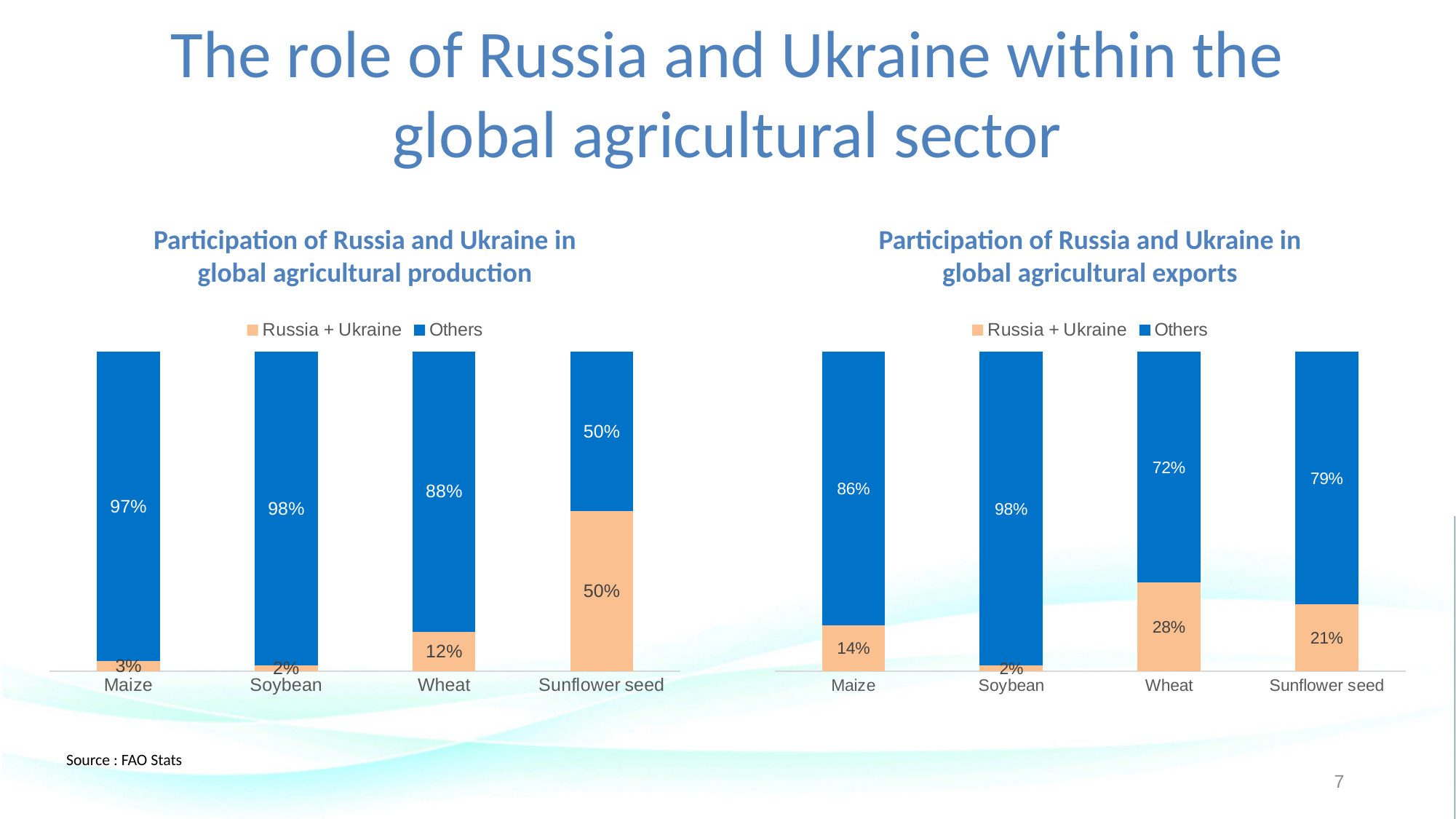
How many series does the legend of the 'Participation of Russia and Ukraine in global agricultural production' chart list? 2 What are the two series listed in the legend of the 'Participation of Russia and Ukraine in global agricultural exports' chart? Russia + Ukraine and Others In the 'Participation of Russia and Ukraine in global agricultural production' chart, is the Russia + Ukraine value for Sunflower seed larger or smaller than the Russia + Ukraine value for Wheat? larger How many categories are shown on the x axis of the 'Participation of Russia and Ukraine in global agricultural exports' chart? 4 In the 'Participation of Russia and Ukraine in global agricultural exports' chart, what is the Others value for Sunflower seed? 79% In the 'Participation of Russia and Ukraine in global agricultural production' chart, which category has the highest Russia + Ukraine share? Sunflower seed In the 'Participation of Russia and Ukraine in global agricultural production' chart, what is the total of the Maize bar? 100% What kind of chart is the 'Participation of Russia and Ukraine in global agricultural production' chart? Stacked bar chart In the 'Participation of Russia and Ukraine in global agricultural exports' chart, what is the Russia + Ukraine value for Wheat? 28% In the 'Participation of Russia and Ukraine in global agricultural exports' chart, what is the difference between the Russia + Ukraine values for Wheat and Maize? 14% In the 'Participation of Russia and Ukraine in global agricultural production' chart, what is the Russia + Ukraine value for Wheat? 12% In the 'Participation of Russia and Ukraine in global agricultural exports' chart, which category has the lowest Russia + Ukraine share? Soybean